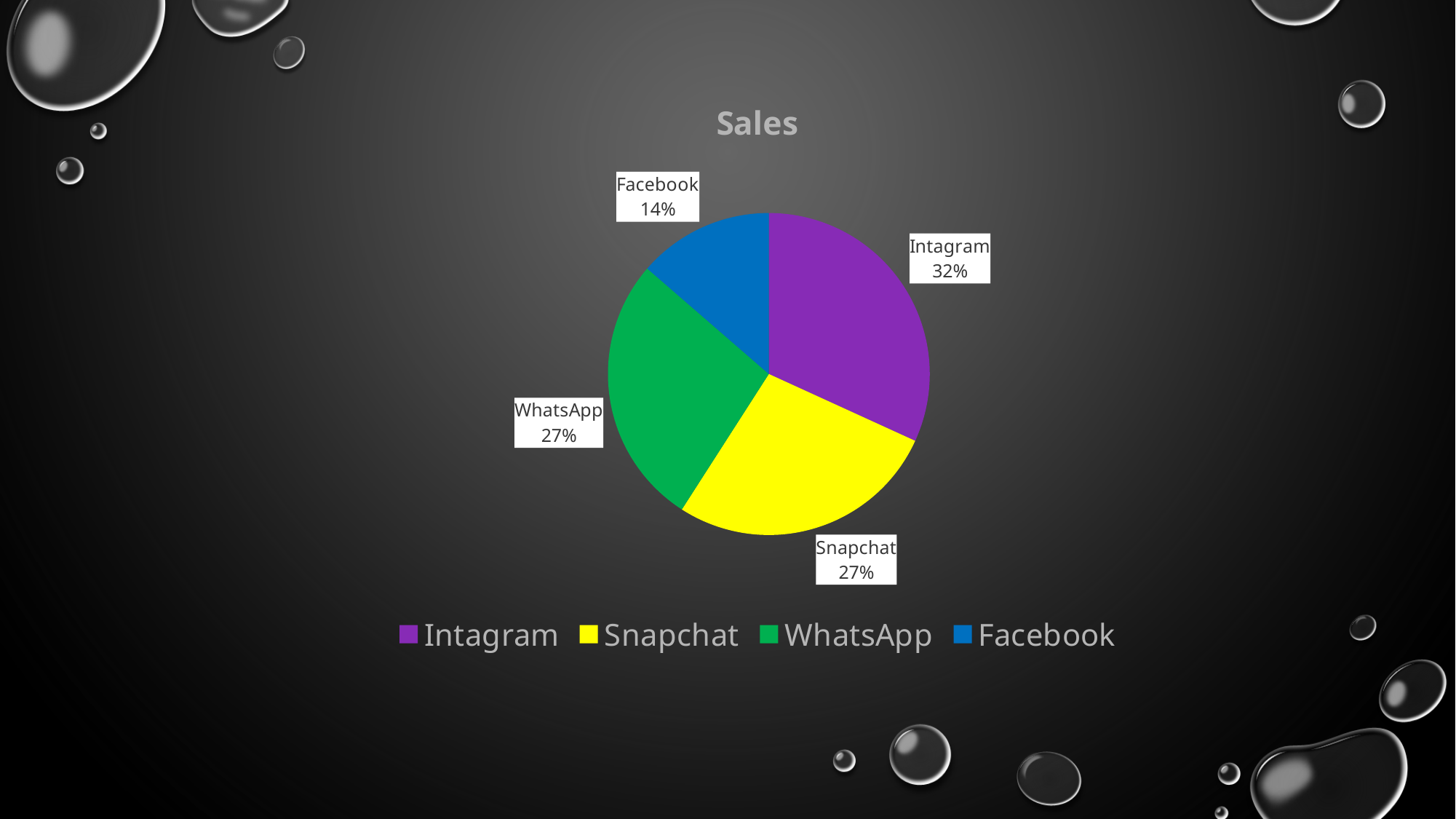
What share of the pie does Snapchat have? 27% What share of the pie does Facebook have? 14% What share of the pie does WhatsApp have? 27% What is the title of the chart? Sales What kind of chart is shown on the slide? pie chart How many categories does the pie chart have? 4 Which category has the largest slice of the pie? Intagram Which category has the smallest slice of the pie? Facebook Which is larger, the share for Intagram or the share for WhatsApp? Intagram What colour is the Snapchat slice? yellow What is the difference in percentage points between Intagram and Facebook? 18